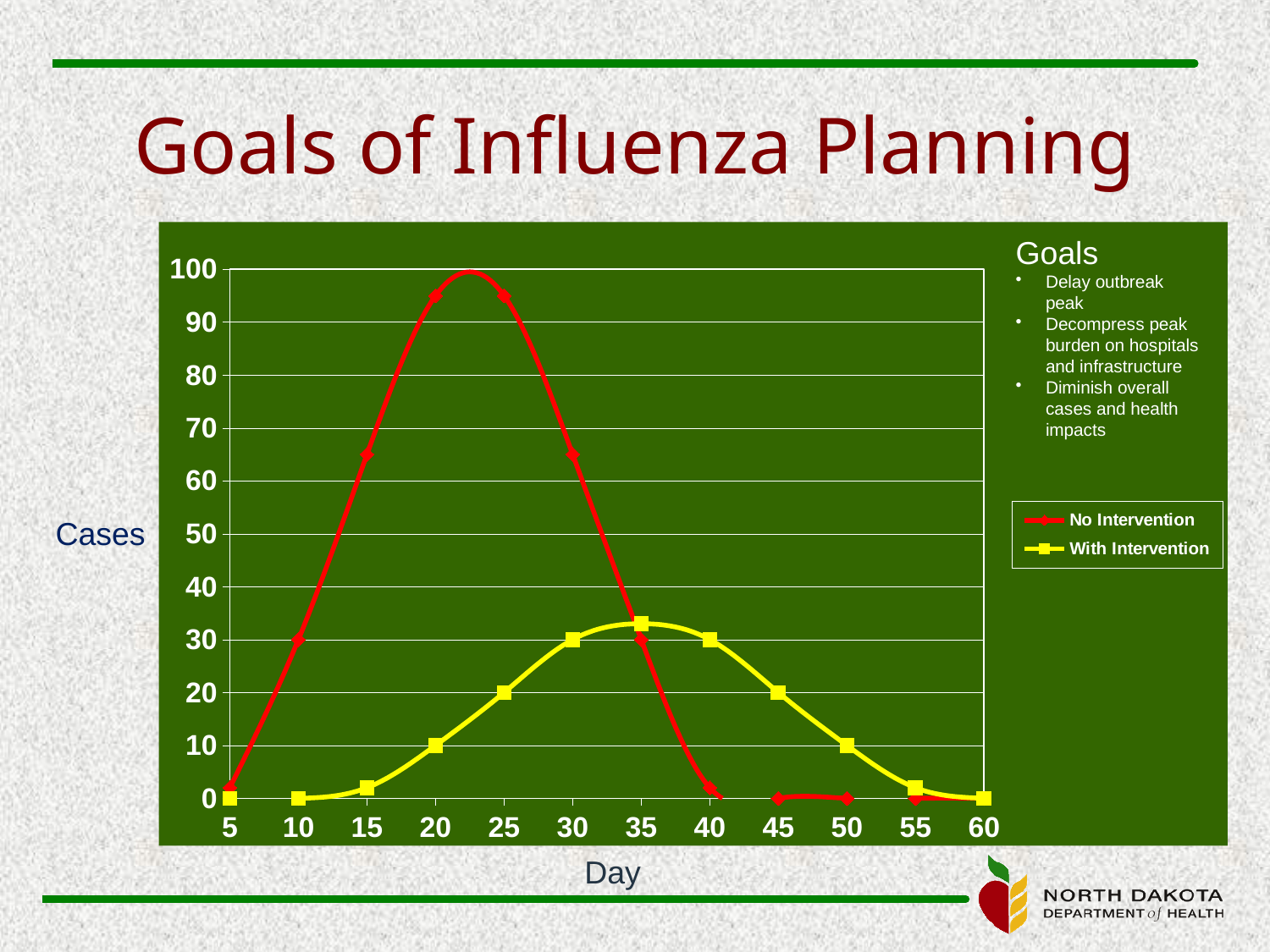
What kind of chart is shown on the slide? line chart At day 45, which series has the larger value, No Intervention or With Intervention? With Intervention What is the value of the No Intervention series at day 10? 30 Is the value of the No Intervention series at day 15 greater or less than 60? greater Do the values of the With Intervention series rise or fall from day 40 to day 60? fall What is the value of the With Intervention series at day 30? 30 At day 15, which series has the larger value, No Intervention or With Intervention? No Intervention How many day values are marked along the x axis? 12 Is the value of the No Intervention series at day 20 greater or less than 90? greater How many series does the legend list? 2 What is the value of the With Intervention series at day 20? 10 Which colour is used for the No Intervention series? red